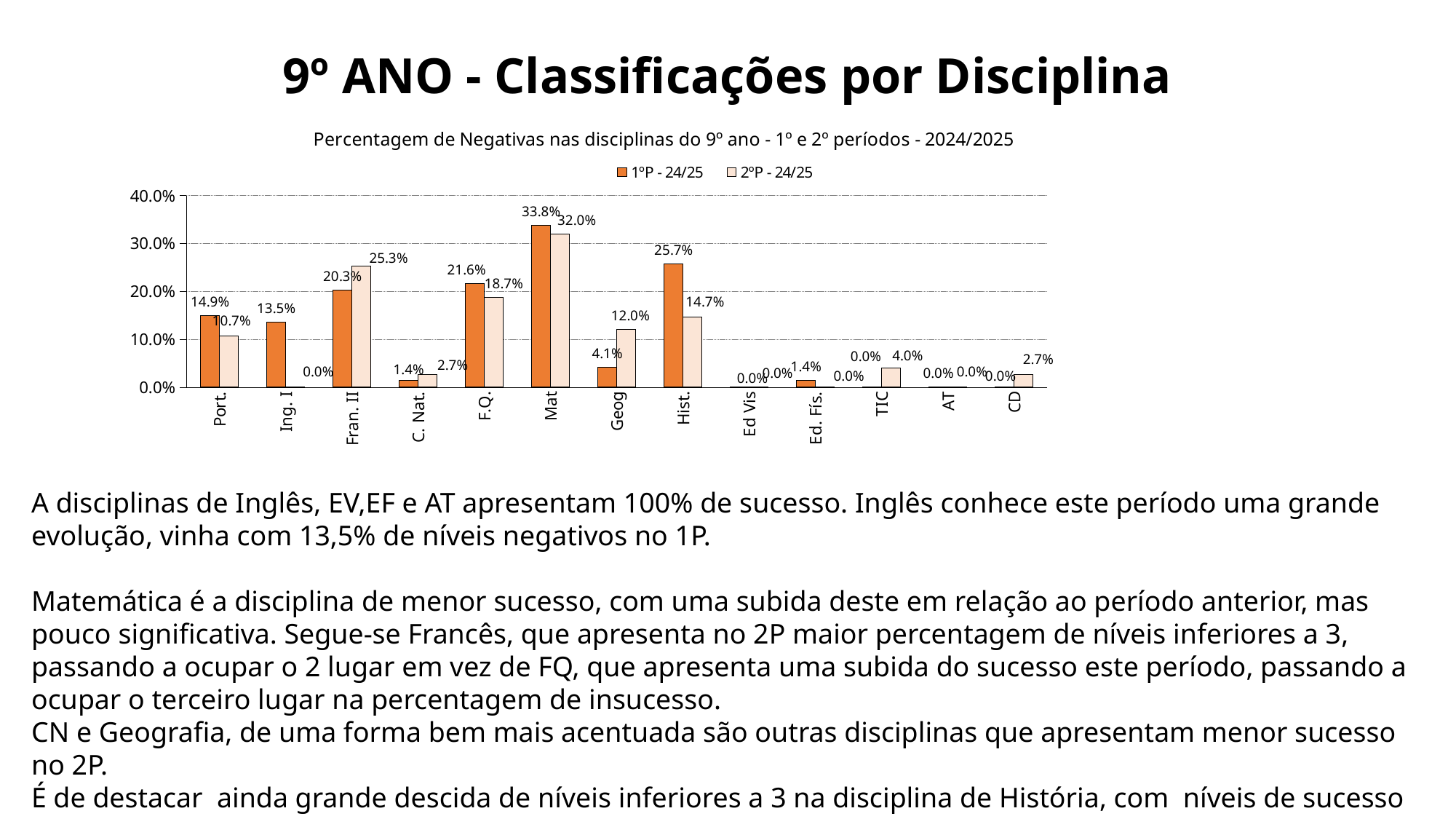
Is the 1ºP - 24/25 value for Hist. greater or less than 20.0%? greater What is the value for Hist. in the 2ºP - 24/25 series? 14.7% Which discipline has the highest value in the 2ºP - 24/25 series? Mat What is the difference between the 2ºP - 24/25 and 1ºP - 24/25 values for Geog? 7.9% What is the difference between the 1ºP - 24/25 and 2ºP - 24/25 values for Hist.? 11.0% Which is larger for F.Q.: the 1ºP - 24/25 value or the 2ºP - 24/25 value? 1ºP - 24/25 What is the value for Fran. II in the 2ºP - 24/25 series? 25.3% Which discipline has the highest value in the 1ºP - 24/25 series? Mat What is the value for Mat in the 1ºP - 24/25 series? 33.8% How many series does the legend list? 2 What kind of chart is shown on the slide? Bar chart How many disciplines are shown on the x axis? 13